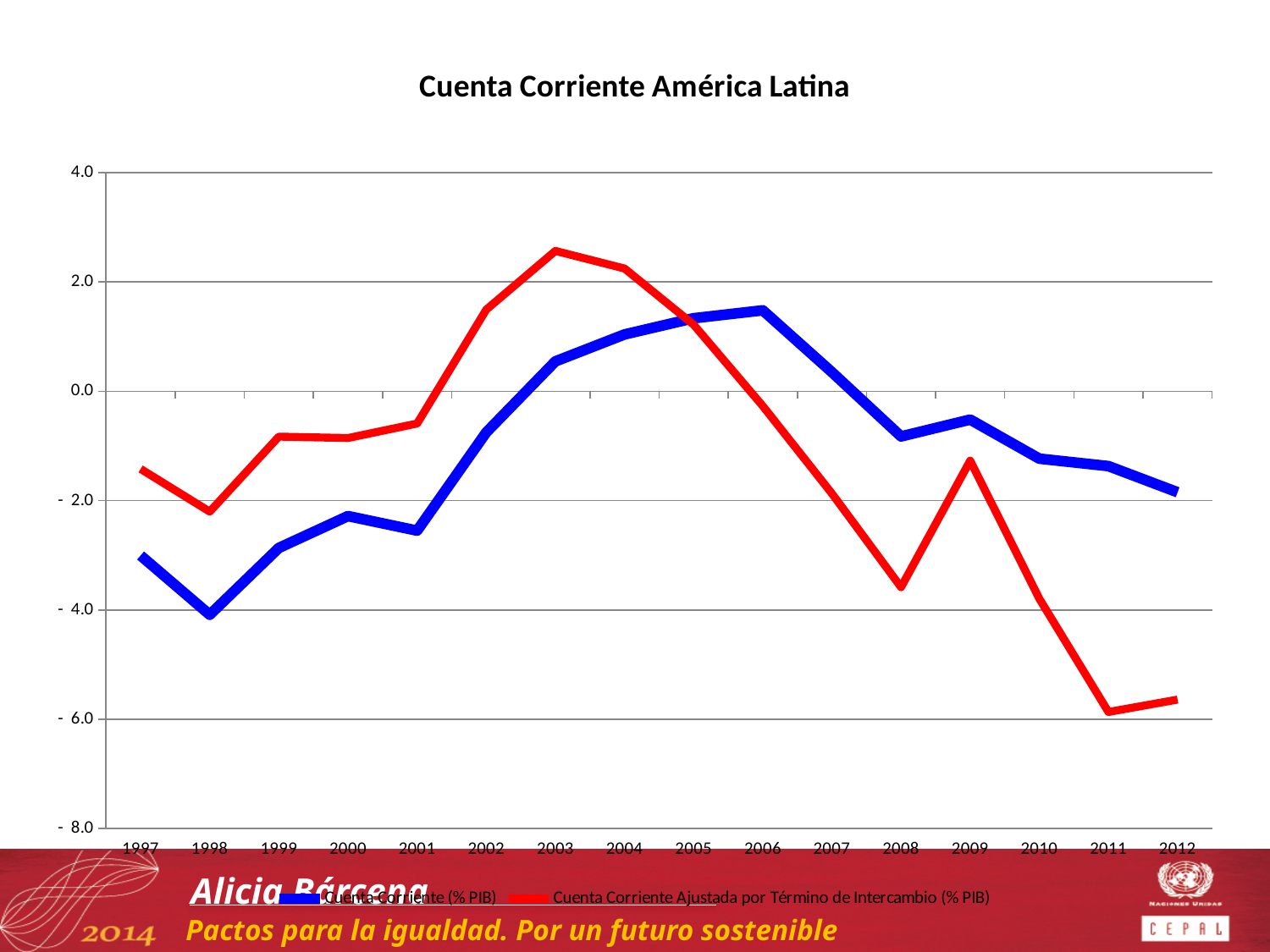
How many years are plotted along the x axis? 16 In which year does the Cuenta Corriente Ajustada por Término de Intercambio (% PIB) series reach its highest value? 2003 What kind of chart is shown on the slide? line chart In 2012, which series has the larger value: Cuenta Corriente (% PIB) or Cuenta Corriente Ajustada por Término de Intercambio (% PIB)? Cuenta Corriente (% PIB) In which year does the Cuenta Corriente (% PIB) series reach its lowest value? 1998 In which year does the Cuenta Corriente (% PIB) series reach its highest value? 2006 What is the title of the chart? Cuenta Corriente América Latina Is the value for Cuenta Corriente (% PIB) in 2006 greater or less than 0.0? greater Does the Cuenta Corriente (% PIB) series rise or fall from 2006 to 2012? fall How many series does the legend list? 2 Is the value for Cuenta Corriente Ajustada por Término de Intercambio (% PIB) in 2003 greater or less than 2.0? greater Is the value for Cuenta Corriente Ajustada por Término de Intercambio (% PIB) in 2011 greater or less than -4.0? less